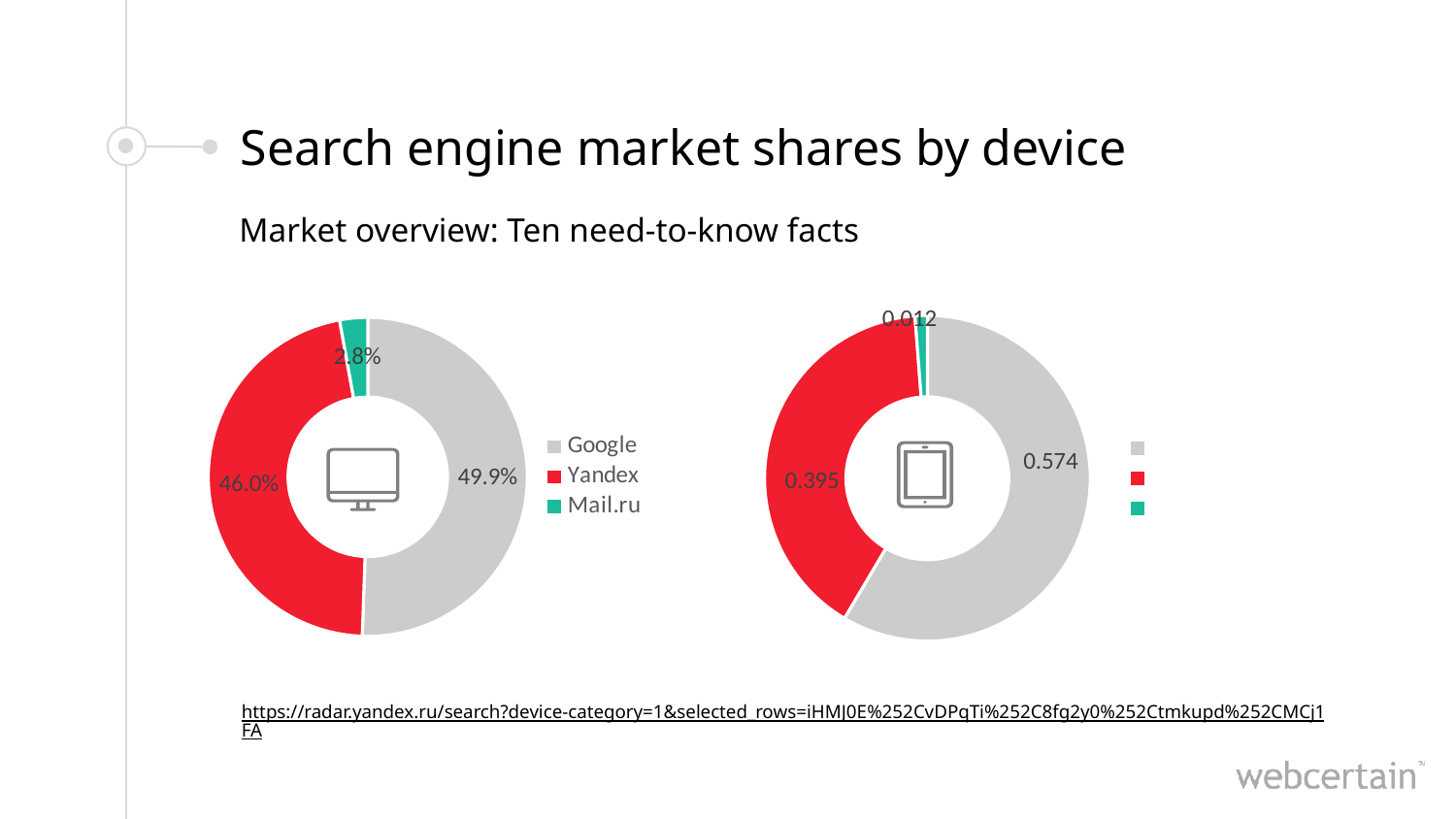
In the left chart (desktop), what is the market share shown for Mail.ru? 2.8% What kind of chart is used on this slide? Doughnut chart In the left chart (desktop), what is the market share shown for Yandex? 46.0% How many entries does the legend of the left chart (desktop) list? 3 In the right chart (tablet), what value is shown on the green slice? 0.012 In the right chart (tablet), what value is shown on the red slice? 0.395 In the left chart (desktop), which search engine has the largest share? Google In the right chart (tablet), what value is shown on the grey slice? 0.574 In the left chart (desktop), which is larger: the share for Yandex or the share for Mail.ru? Yandex In the left chart (desktop), what is the market share shown for Google? 49.9% In the left chart (desktop), how much larger is Google's share than Yandex's share? 3.9% In the left chart (desktop), which search engine has the smallest share? Mail.ru